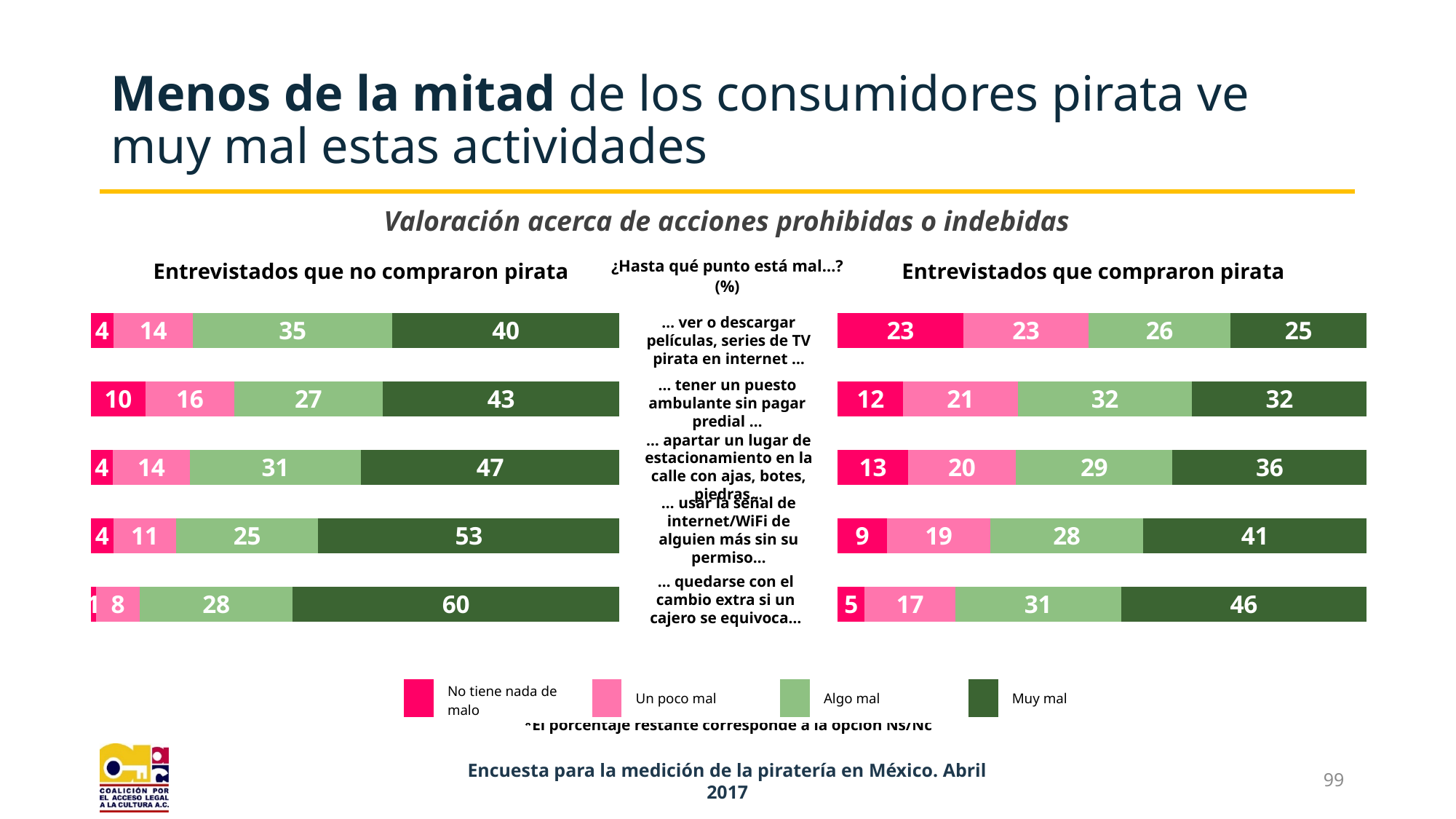
In the chart 'Entrevistados que no compraron pirata', what percentage answered 'Muy mal' for '... quedarse con el cambio extra si un cajero se equivoca...'? 60 In the chart 'Entrevistados que compraron pirata', what percentage answered 'No tiene nada de malo' for '... ver o descargar películas, series de TV pirata en internet ...'? 23 In the chart 'Entrevistados que compraron pirata', what percentage answered 'Algo mal' for '... tener un puesto ambulante sin pagar predial ...'? 32 How many activities (bars) are shown in the chart 'Entrevistados que no compraron pirata'? 5 In the chart 'Entrevistados que compraron pirata', what is the total of the four labelled segments for '... ver o descargar películas, series de TV pirata en internet ...'? 97 In the chart 'Entrevistados que no compraron pirata', which activity has the highest 'Muy mal' percentage? ... quedarse con el cambio extra si un cajero se equivoca... What kind of chart is used for 'Entrevistados que compraron pirata'? Stacked bar chart How many series does the legend list? 4 In the chart 'Entrevistados que compraron pirata', is the 'No tiene nada de malo' percentage larger for '... tener un puesto ambulante sin pagar predial ...' or for '... apartar un lugar de estacionamiento en la calle con ajas, botes, piedras...'? ... apartar un lugar de estacionamiento en la calle con ajas, botes, piedras... In the chart 'Entrevistados que compraron pirata', which activity has the lowest 'Muy mal' percentage? ... ver o descargar películas, series de TV pirata en internet ... What is the difference between the 'Muy mal' percentage for '... usar la señal de internet/WiFi de alguien más sin su permiso...' in the 'no compraron pirata' chart and in the 'compraron pirata' chart? 12 Which legend entry is shown in the darkest green colour? Muy mal